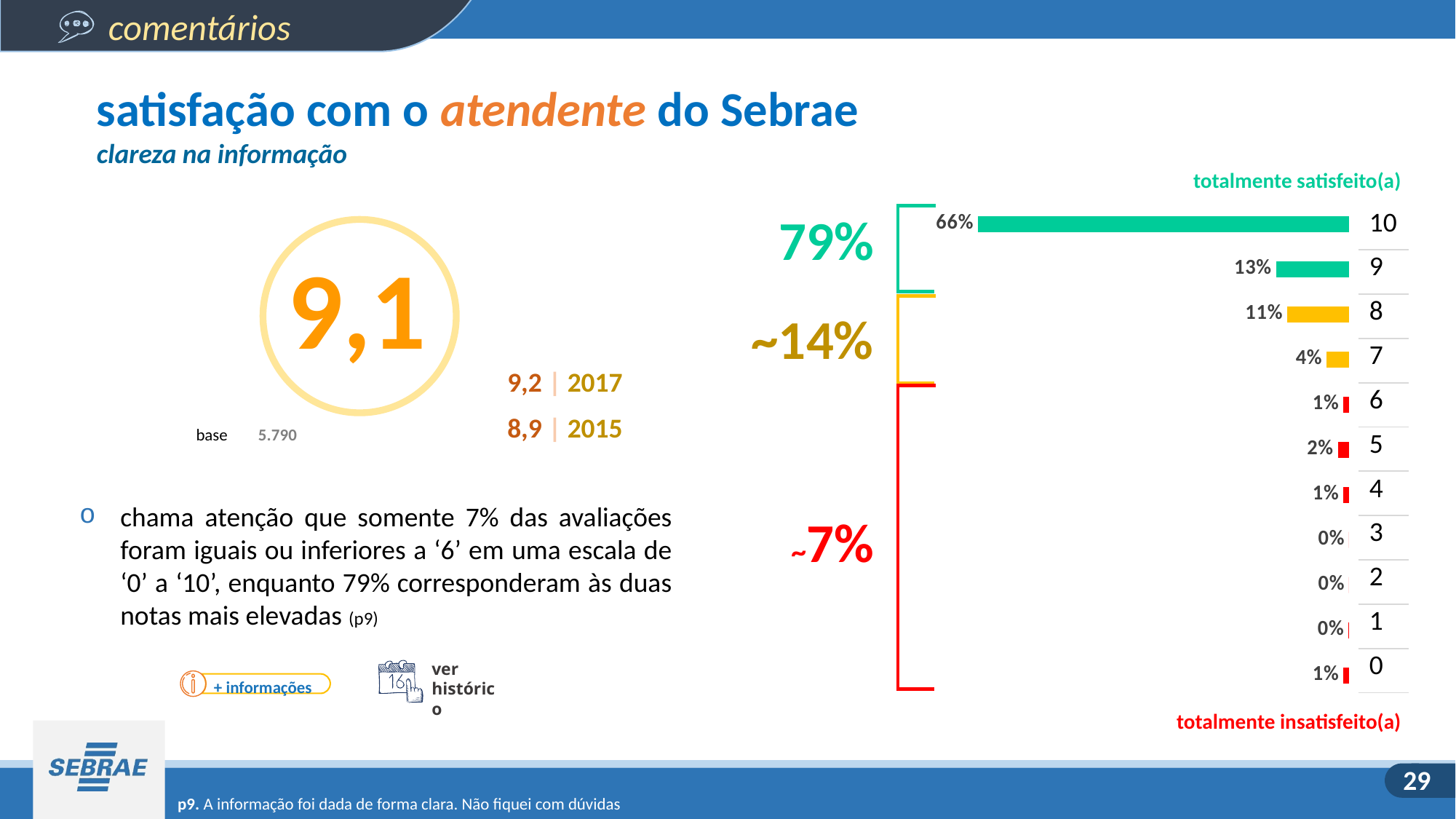
Which score has the highest percentage of respondents? 10 How many score categories are shown in the chart? 11 What percentage of respondents gave a score of 10? 66% What label appears above the chart at the top of the score scale? totalmente satisfeito(a) What kind of chart is used to show the distribution of scores? bar chart What percentage of respondents gave a score of 5? 2% Which has a larger percentage, score 8 or score 7? 8 What percentage of respondents gave a score of 0? 1% What percentage of respondents gave a score of 8? 11% What percentage of respondents gave a score of 7? 4% What is the difference between the percentage for score 10 and the percentage for score 9? 53% What percentage of respondents gave a score of 9? 13%